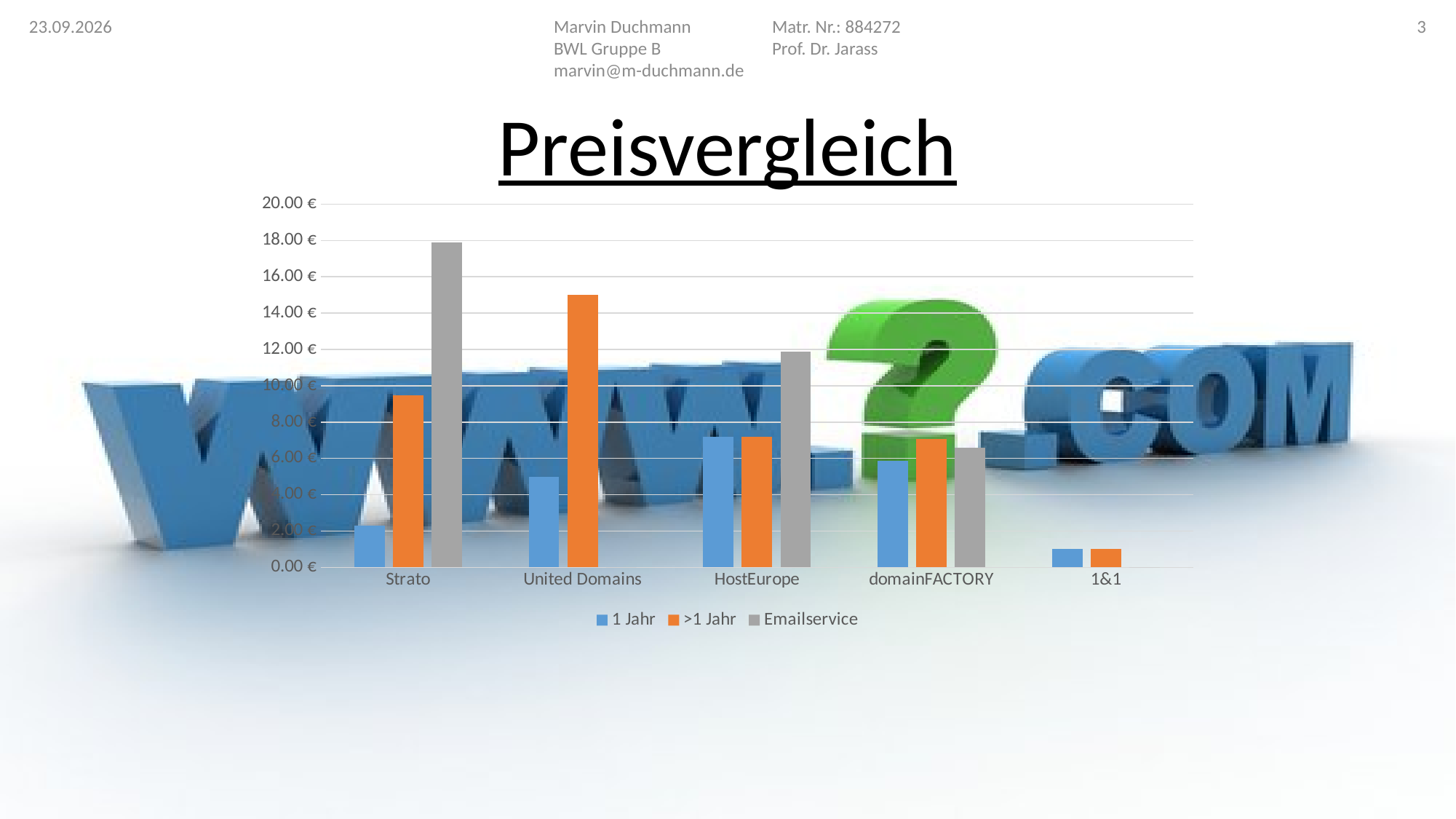
Which provider has a larger 1 Jahr value, HostEurope or Strato? HostEurope Is the >1 Jahr value for United Domains greater or less than 14.00 €? greater Which provider has the lowest 1 Jahr value? 1&1 How many providers are compared along the x axis of the chart? 5 What is the title of the chart on the slide? Preisvergleich Is the 1 Jahr value for Strato greater or less than 4.00 €? less Is the Emailservice value for Strato greater or less than 16.00 €? greater Which is larger for HostEurope: the Emailservice value or the 1 Jahr value? Emailservice What kind of chart is shown on the slide? bar chart How many series does the chart's legend list? 3 Which provider has the highest Emailservice value? Strato Which provider has the highest >1 Jahr value? United Domains